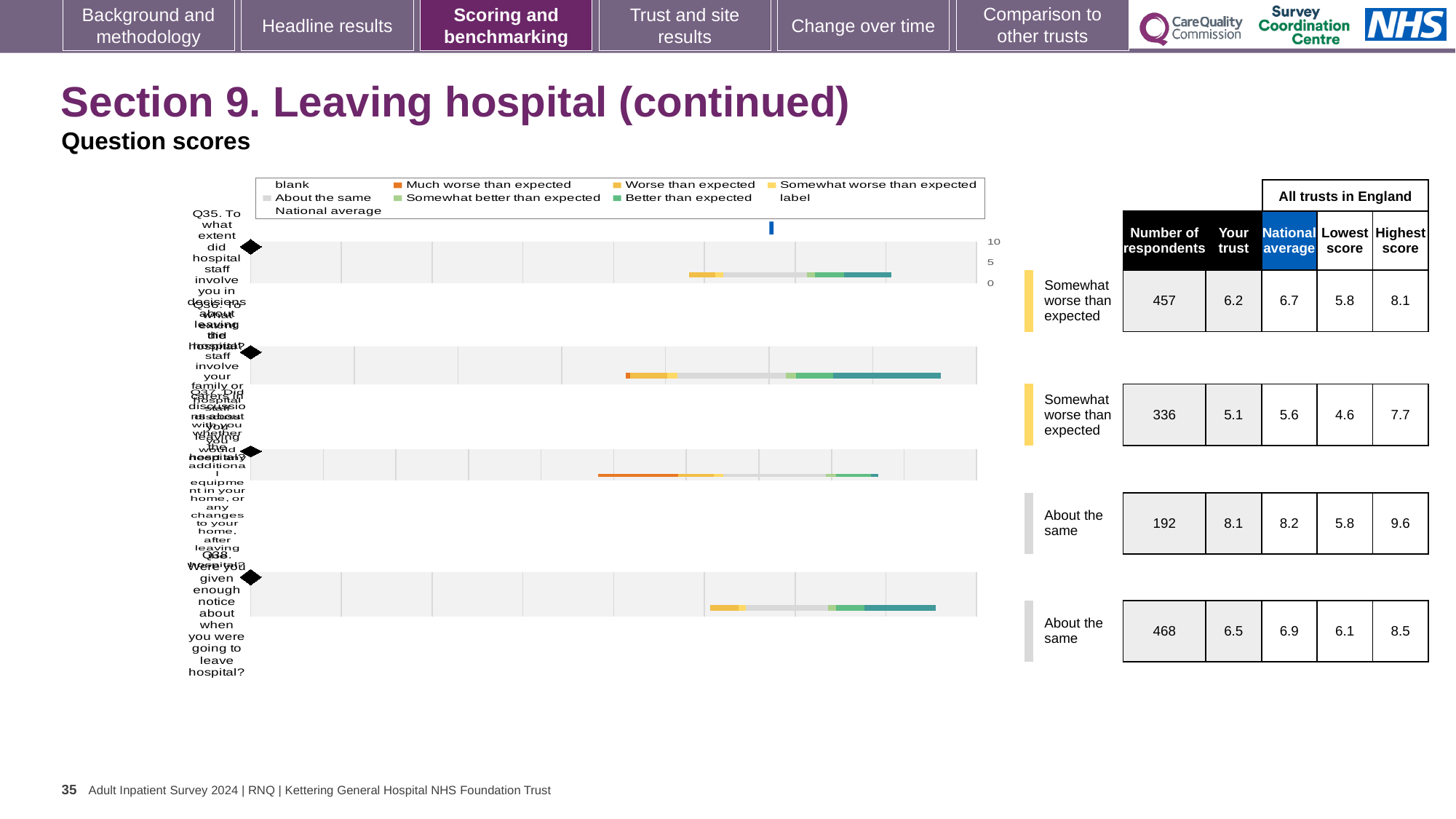
What kind of chart is used to show the question scores on this slide? bar chart What is the highest score across all trusts in England for the second row (Q36)? 7.7 According to the table beside the chart, how many respondents answered Q38 (enough notice about leaving hospital)? 468 Which question row has the highest number of respondents in the table beside the chart? Q38 For Q35, what is the difference between the national average and the 'Your trust' score shown in the table? 0.5 For the third row (Q37), which is larger: the 'Your trust' score or the national average? National average What benchmark category is shown for Q35 next to the chart? Somewhat worse than expected What benchmark category is shown for Q38 next to the chart? About the same Which question row has the lowest 'Your trust' score in the table beside the chart? Q36 How many questions (rows) are plotted in the question scores chart? 4 According to the table beside the chart, what is the 'Your trust' score for Q35 (involving you in decisions about leaving hospital)? 6.2 What is the lowest score across all trusts in England for the third row (Q37)? 5.8